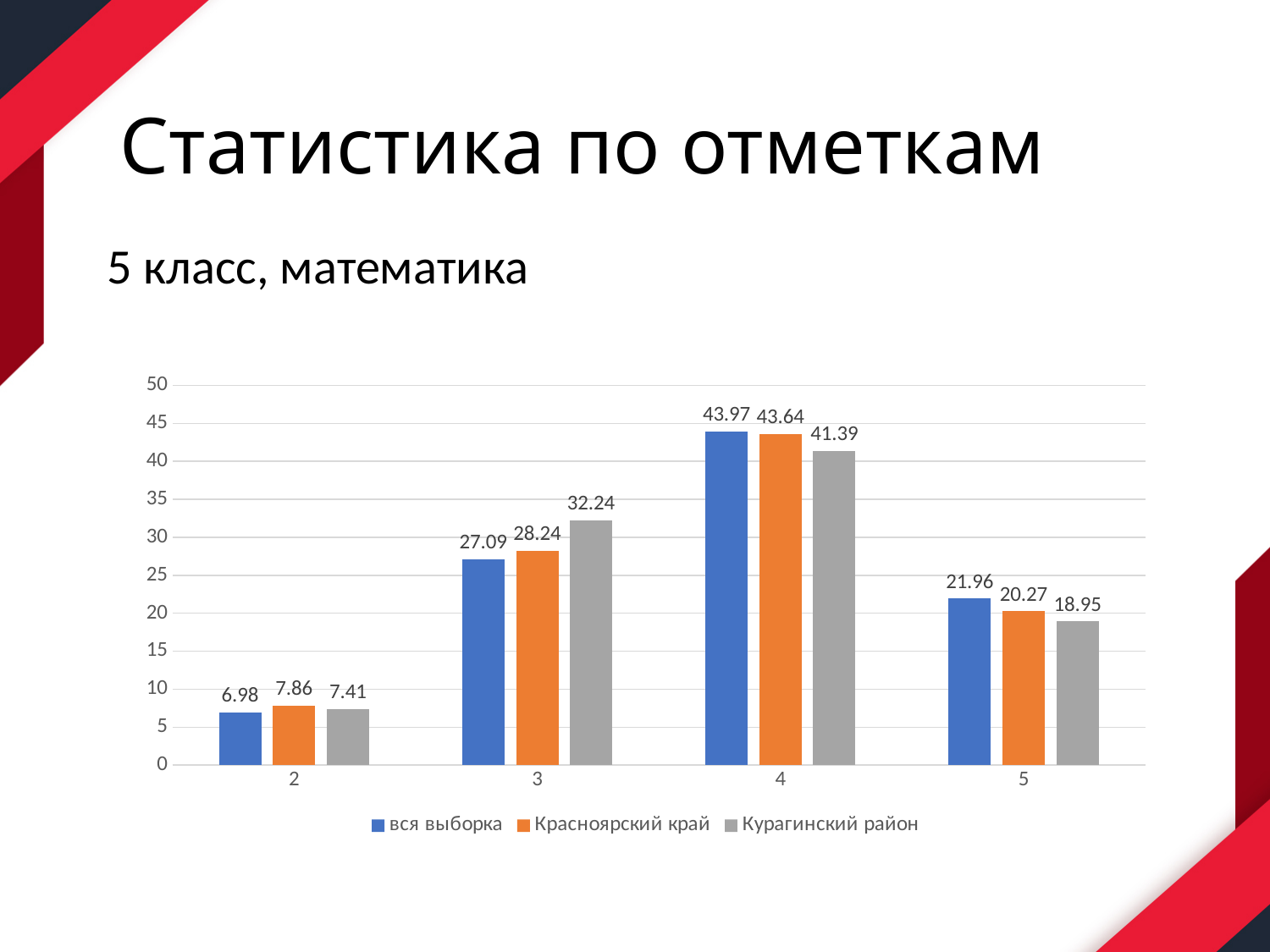
What is the value for "вся выборка" at mark 5? 21.96 Is the value for "Красноярский край" at mark 4 greater or less than 40? greater How many series does the legend list? 3 Which series is shown in orange? Красноярский край At mark 5, which is larger: "вся выборка" or "Курагинский район"? вся выборка What is the value for "Красноярский край" at mark 2? 7.86 How many mark categories are shown on the x axis? 4 What is the difference between "Курагинский район" and "вся выборка" at mark 3? 5.15 What is the value for "Курагинский район" at mark 3? 32.24 For the "Курагинский район" series, which mark has the lowest value? 2 For the "вся выборка" series, which mark has the highest value? 4 What kind of chart is shown on the slide? bar chart